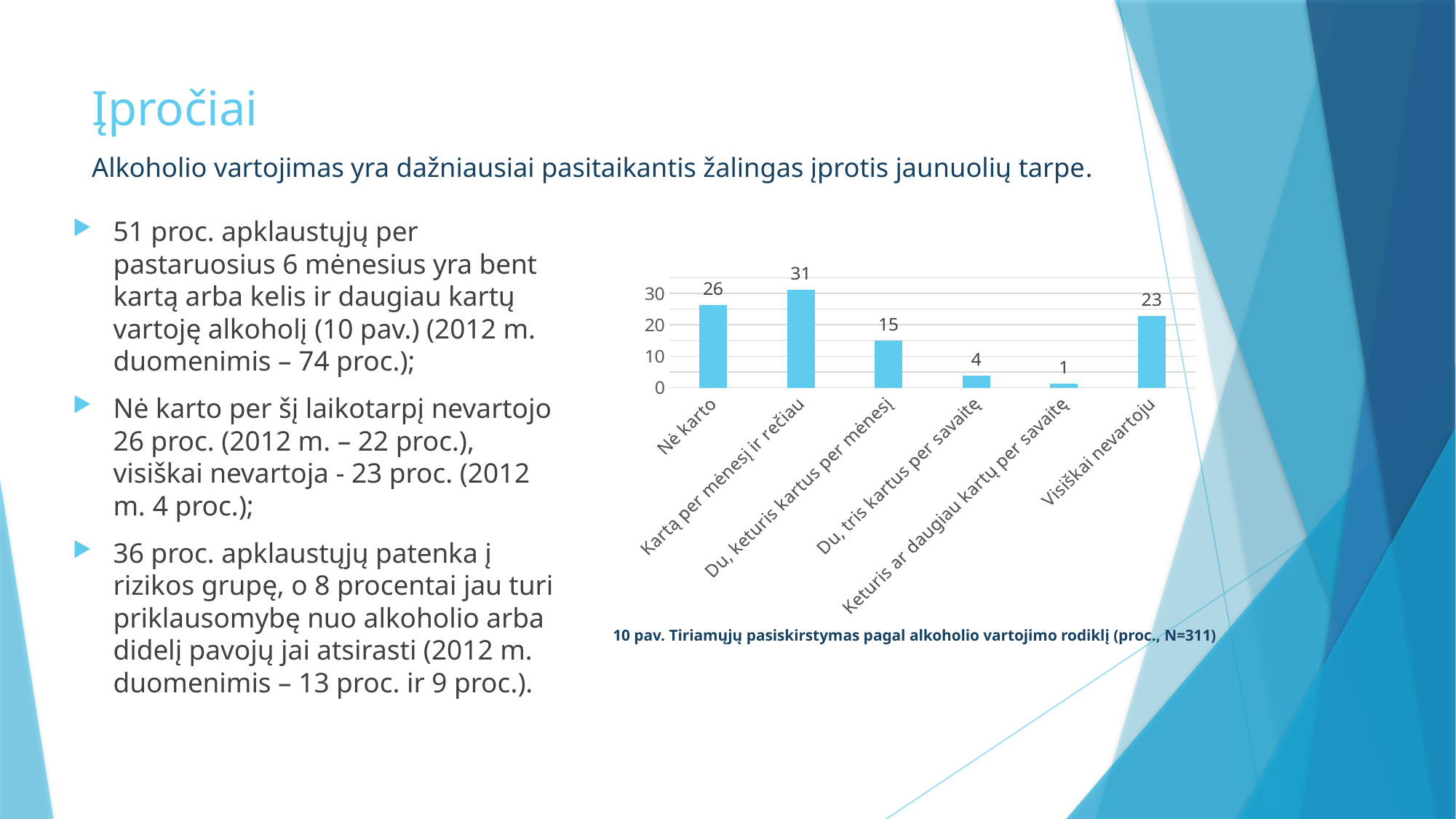
Which category has the highest value? Kartą per mėnesį ir rečiau What is the value for "Du, keturis kartus per mėnesį"? 15 What is the difference between the values for "Kartą per mėnesį ir rečiau" and "Nė karto"? 5 What is the value for "Kartą per mėnesį ir rečiau"? 31 Which is larger, the value for "Nė karto" or the value for "Visiškai nevartoju"? Nė karto What is the value for "Nė karto"? 26 Which category has the lowest value? Keturis ar daugiau kartų per savaitę How many categories are shown on the x axis of the chart? 6 What kind of chart is shown on the slide? bar chart What is the caption printed below the chart? 10 pav. Tiriamųjų pasiskirstymas pagal alkoholio vartojimo rodiklį (proc., N=311) Is the value for "Du, tris kartus per savaitę" greater or less than 10? less What is the value for "Visiškai nevartoju"? 23